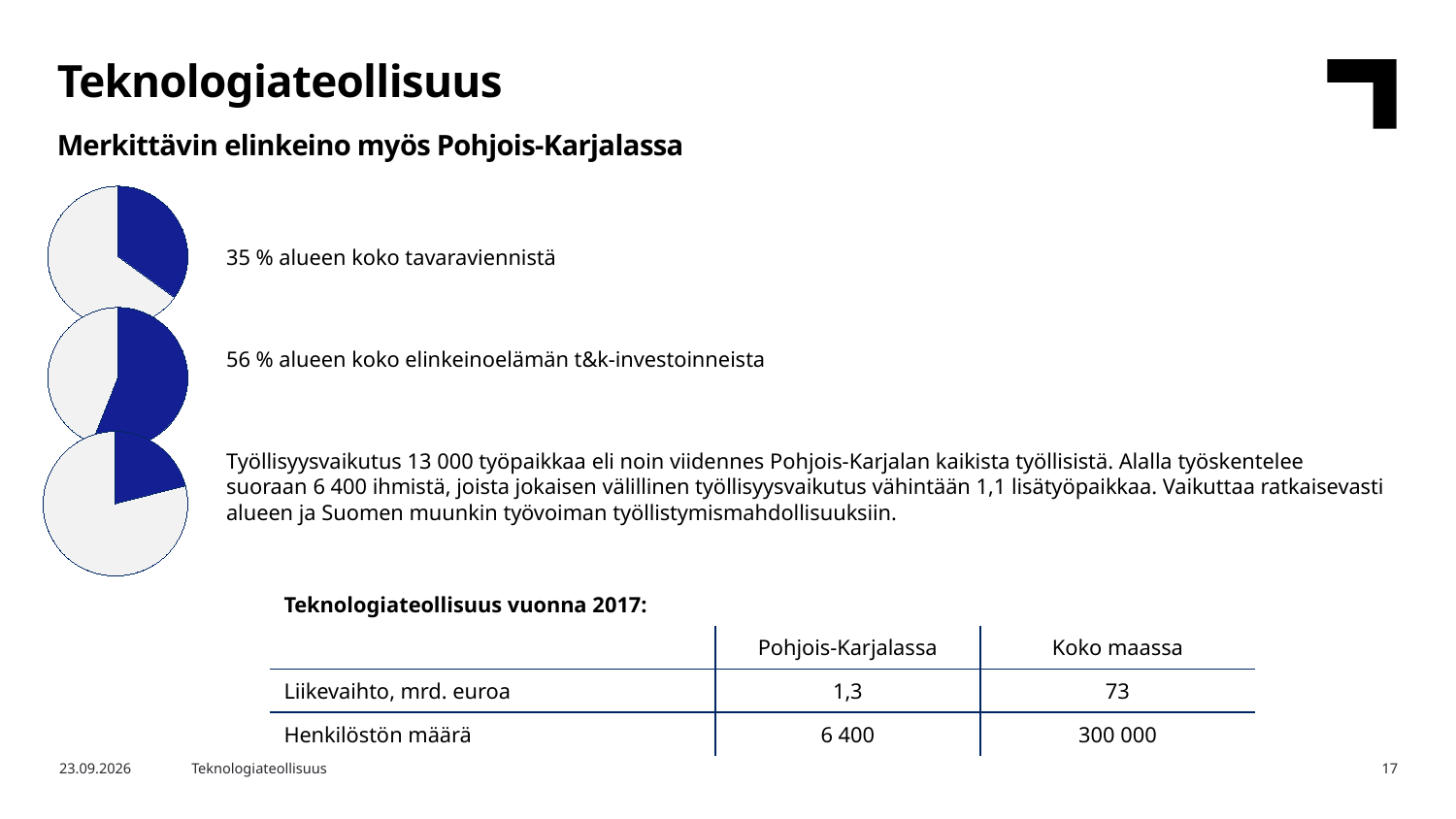
Which of the three pie charts has the largest blue slice? The middle pie chart In the top pie chart, what share of the region's total goods exports does the blue slice represent, according to the text beside it? 35 % What kind of charts are shown on the left side of the slide? Pie charts What colour is used for the highlighted slice in the pie charts? Blue Is the blue slice in the top pie chart larger or smaller than the blue slice in the middle pie chart? Smaller How many slices does each pie chart have? 2 How many pie charts are on the slide? 3 In the middle pie chart, what share of the region's business R&D investments does the blue slice represent, according to the text beside it? 56 % What is the difference in percentage points between the blue shares of the middle pie chart (56 %) and the top pie chart (35 %)? 21 percentage points Which of the three pie charts has the smallest blue slice? The bottom pie chart Is the blue slice in the bottom pie chart greater or less than 50% of the pie? less Is the blue slice in the middle pie chart greater or less than 50% of the pie? greater